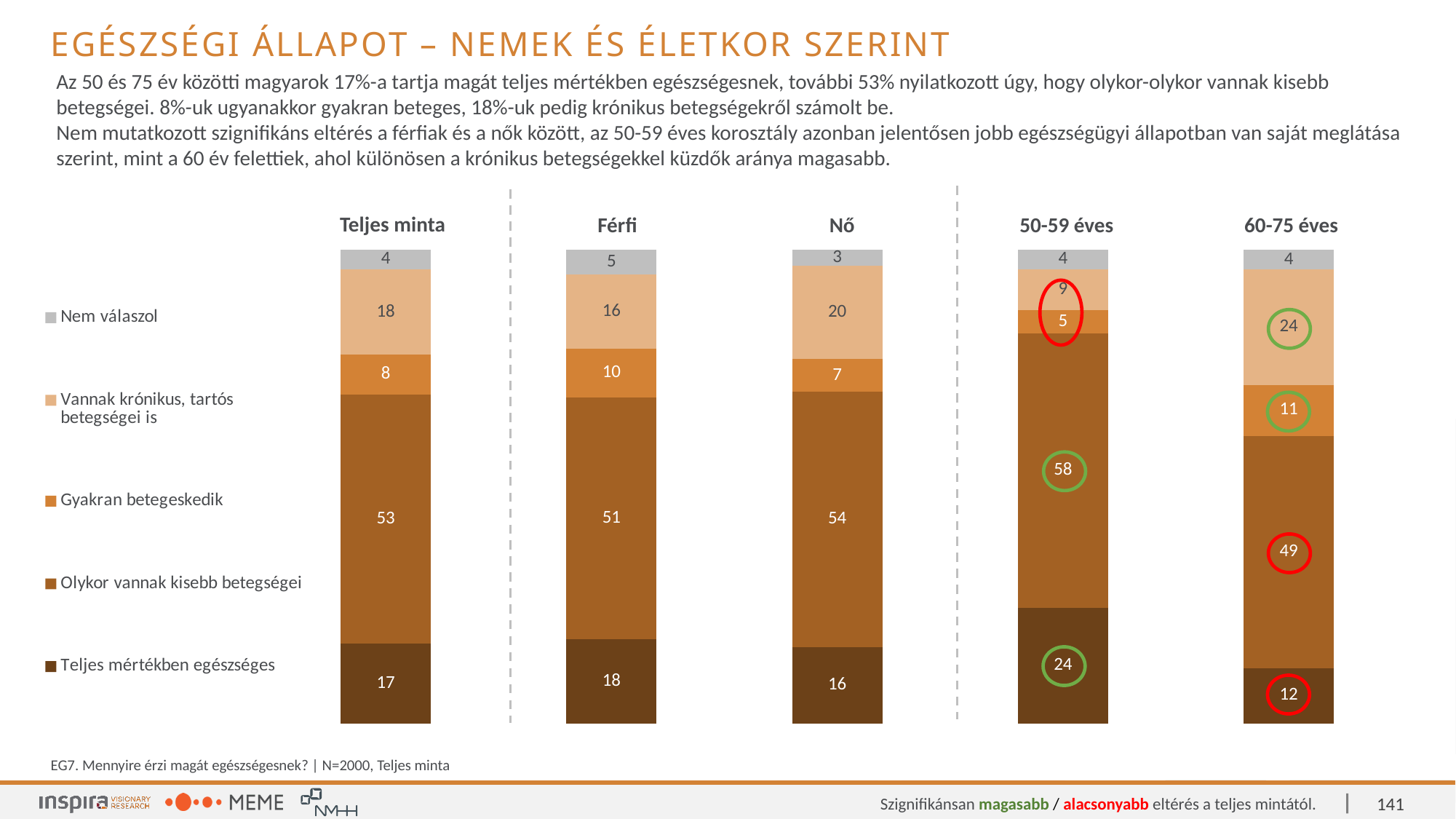
What is the value of 'Gyakran betegeskedik' for Férfi? 10 Which group has the highest value for 'Olykor vannak kisebb betegségei'? 50-59 éves Which is larger: the 'Vannak krónikus, tartós betegségei is' value for Nő or for Férfi? Nő How many bars (groups) are plotted in the chart? 5 What is the total of the stacked bar for Nő? 100 What is the value of 'Teljes mértékben egészséges' for the 50-59 éves group? 24 What is the difference between the 'Teljes mértékben egészséges' values for 50-59 éves and 60-75 éves? 12 What kind of chart is shown on the slide? stacked bar chart What is the value of 'Vannak krónikus, tartós betegségei is' for the 60-75 éves group? 24 How many series does the legend list? 5 Which group has the lowest value for 'Teljes mértékben egészséges'? 60-75 éves What is the value of 'Olykor vannak kisebb betegségei' for Teljes minta? 53